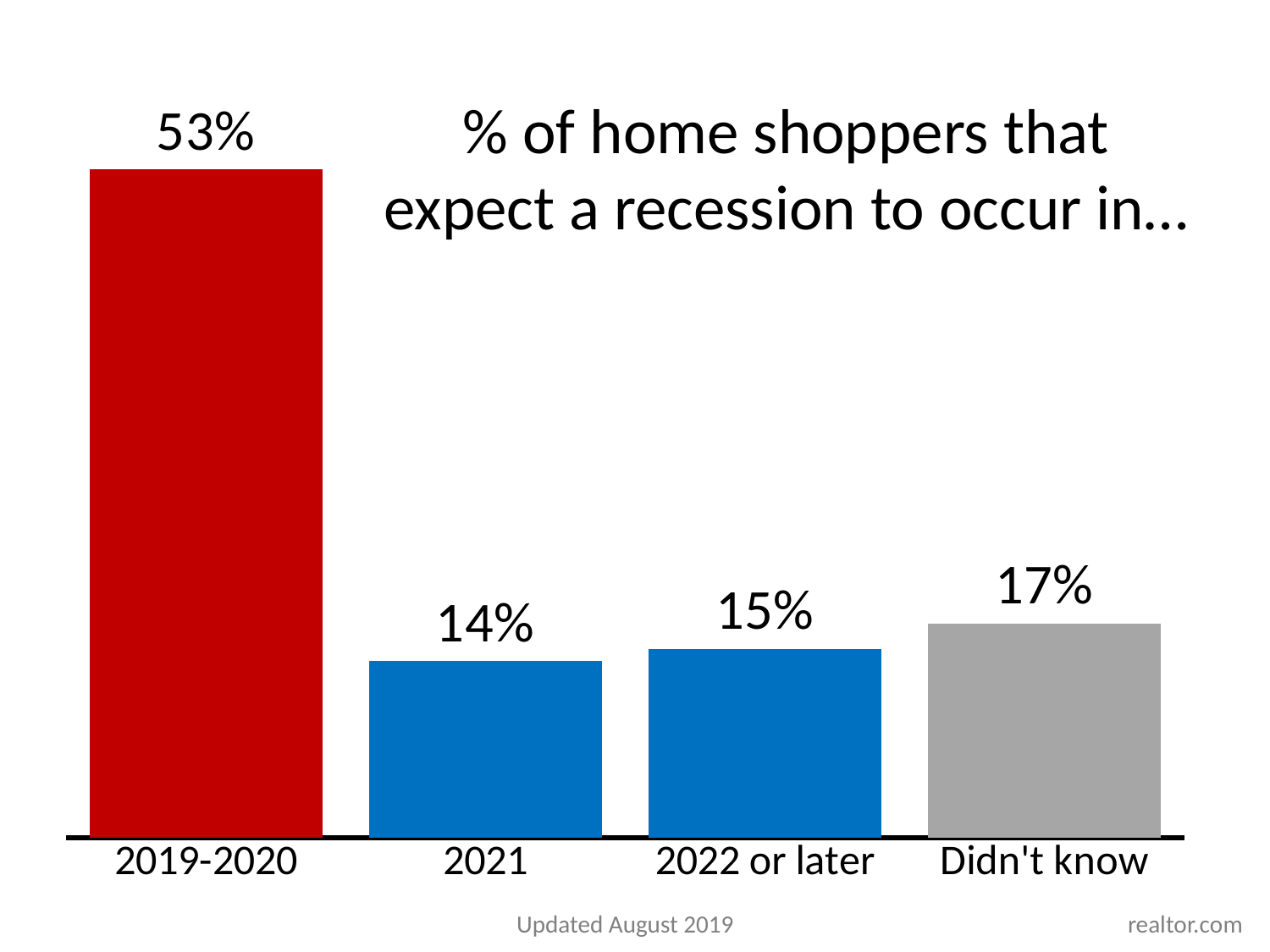
What percentage of home shoppers didn't know when a recession would occur? 17% Which is larger: the percentage for 2019-2020 or the percentage for Didn't know? 2019-2020 What percentage of home shoppers expect a recession to occur in 2022 or later? 15% What kind of chart is shown on the slide? Bar chart What percentage of home shoppers expect a recession to occur in 2019-2020? 53% Which category has the highest percentage of home shoppers? 2019-2020 What percentage of home shoppers expect a recession to occur in 2021? 14% What colour is the bar for 2019-2020? Red How many categories are shown in the chart? 4 What is the difference between the percentage for Didn't know and the percentage for 2022 or later? 2% Which category has the lowest percentage of home shoppers? 2021 What is the difference between the percentage for 2019-2020 and the percentage for 2021? 39%